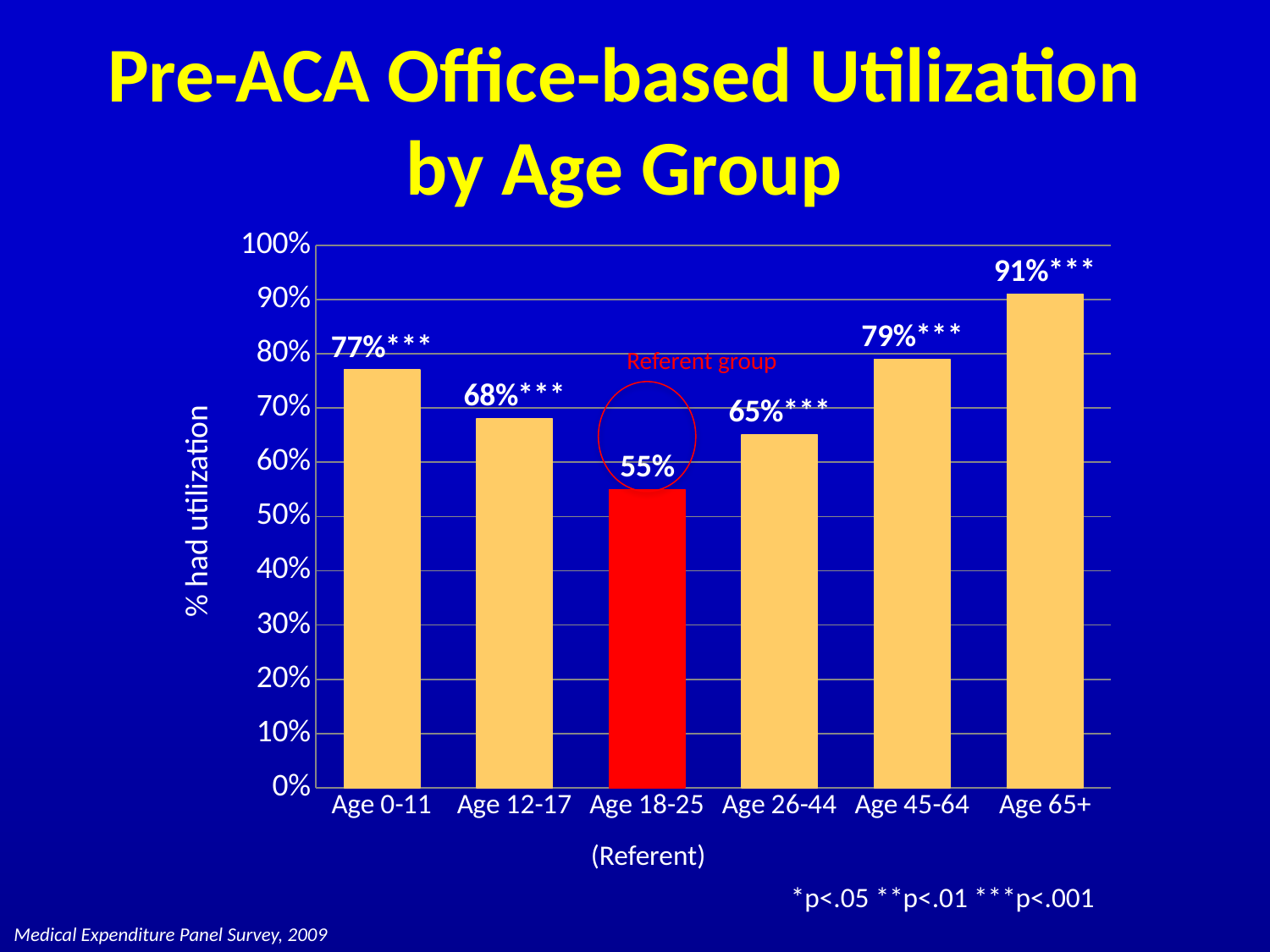
What is the value for Age 18-25? 55% What kind of chart is shown on the slide? bar chart Which age group has the highest utilization? Age 65+ Which is larger, the value for Age 12-17 or the value for Age 26-44? Age 12-17 How many age groups are shown in the chart? 6 Which age group has the lowest utilization? Age 18-25 What is the value for Age 0-11? 77% What is the label of the y axis? % had utilization Which bar is coloured red? Age 18-25 Is the value for Age 45-64 greater or less than 70%? greater What is the value for Age 65+? 91% What is the difference between the values for Age 65+ and Age 18-25? 36%